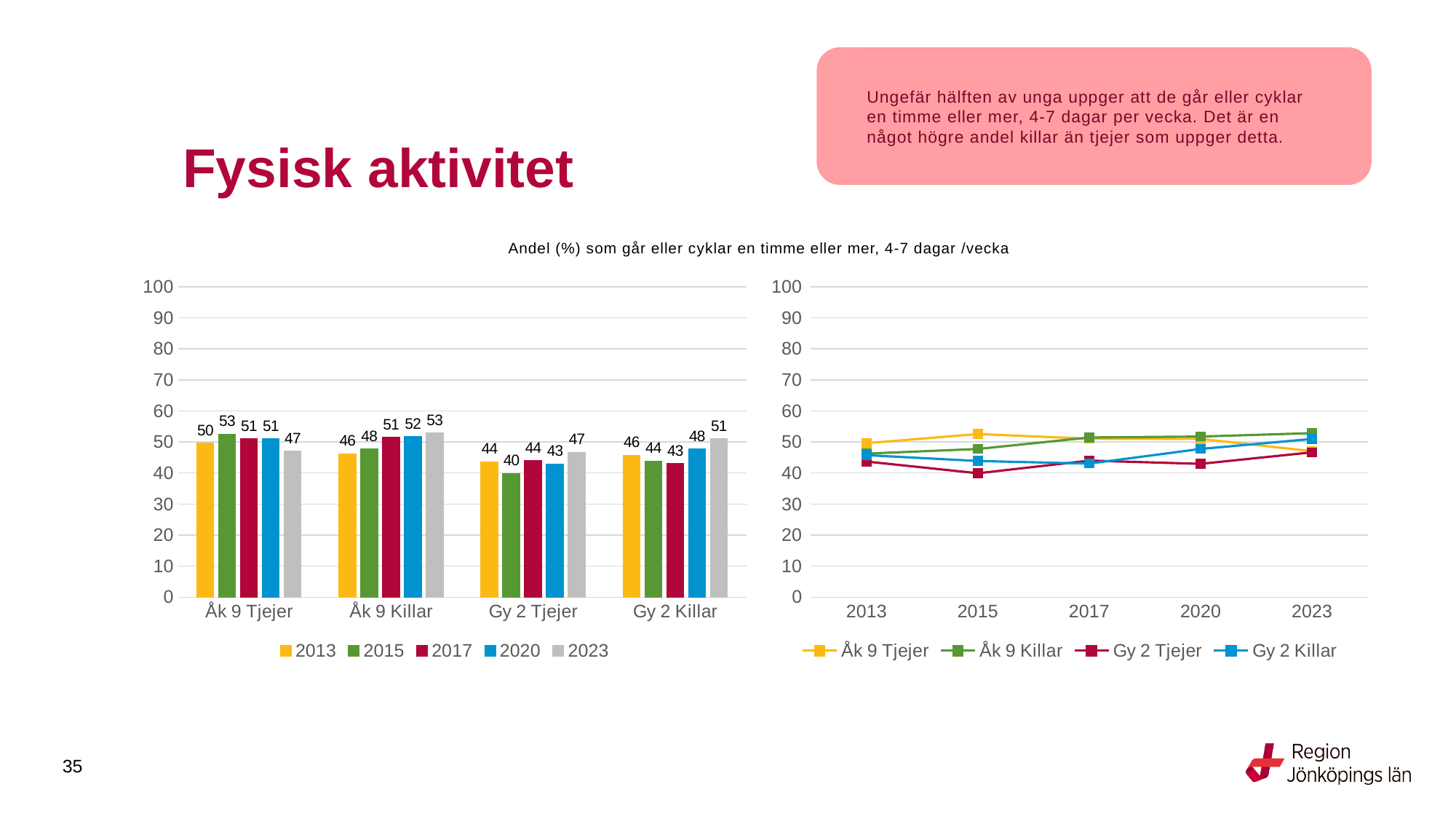
How many series does the legend of the left bar chart list? 5 In the left bar chart, which year has the highest value for Åk 9 Killar? 2023 In the left bar chart, what is the value for Gy 2 Killar in 2020? 48 In the left bar chart, what is the value for Gy 2 Tjejer in 2015? 40 In the left bar chart, what is the difference between the 2023 values for Åk 9 Killar and Gy 2 Tjejer? 6 In the right line chart, does the Åk 9 Killar line rise or fall from 2013 to 2023? Rises What kind of chart is the chart on the right side of the slide? Line chart In the left bar chart, which year has the lowest value for Gy 2 Tjejer? 2015 How many categories are shown on the x axis of the left bar chart? 4 In the left bar chart, which is larger for Åk 9 Tjejer: the 2015 value or the 2023 value? 2015 In the right line chart, is the value for Gy 2 Tjejer in 2015 greater or less than 50? less In the left bar chart, what is the value for Åk 9 Killar in 2023? 53